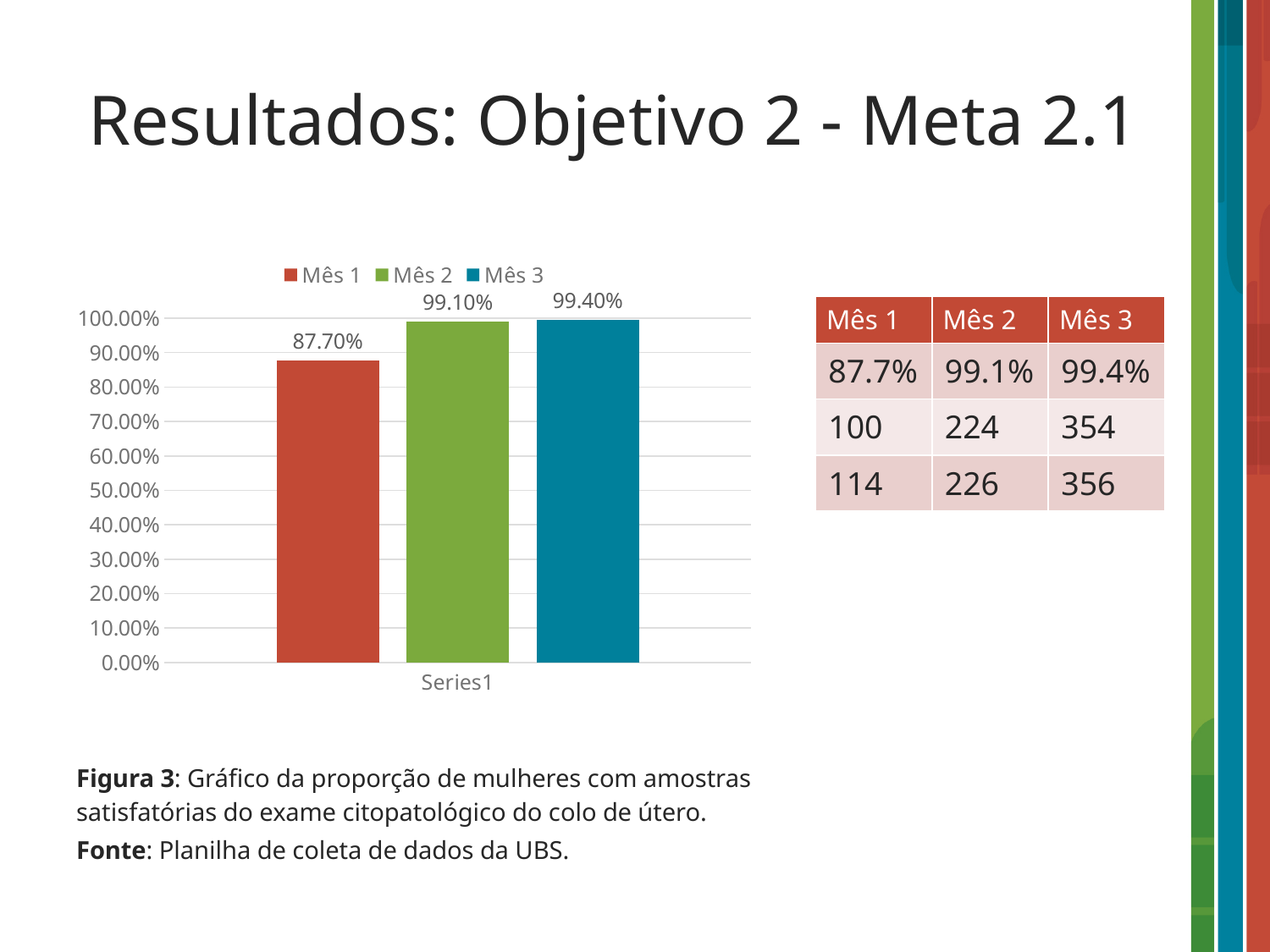
What colour is the bar for Mês 3? teal blue Which is larger, the value for Mês 1 or the value for Mês 2? Mês 2 Which series has the lowest value in the chart? Mês 1 Is the value for Mês 1 greater or less than 90.00%? less How many series does the legend list? 3 What is the difference between the values for Mês 3 and Mês 2? 0.30% What kind of chart is shown on the slide? bar chart What is the value shown for Mês 2 in the chart? 99.10% What is the difference between the values for Mês 2 and Mês 1? 11.40% What is the value shown for Mês 3 in the chart? 99.40% Which series has the highest value in the chart? Mês 3 What is the value shown for Mês 1 in the chart? 87.70%